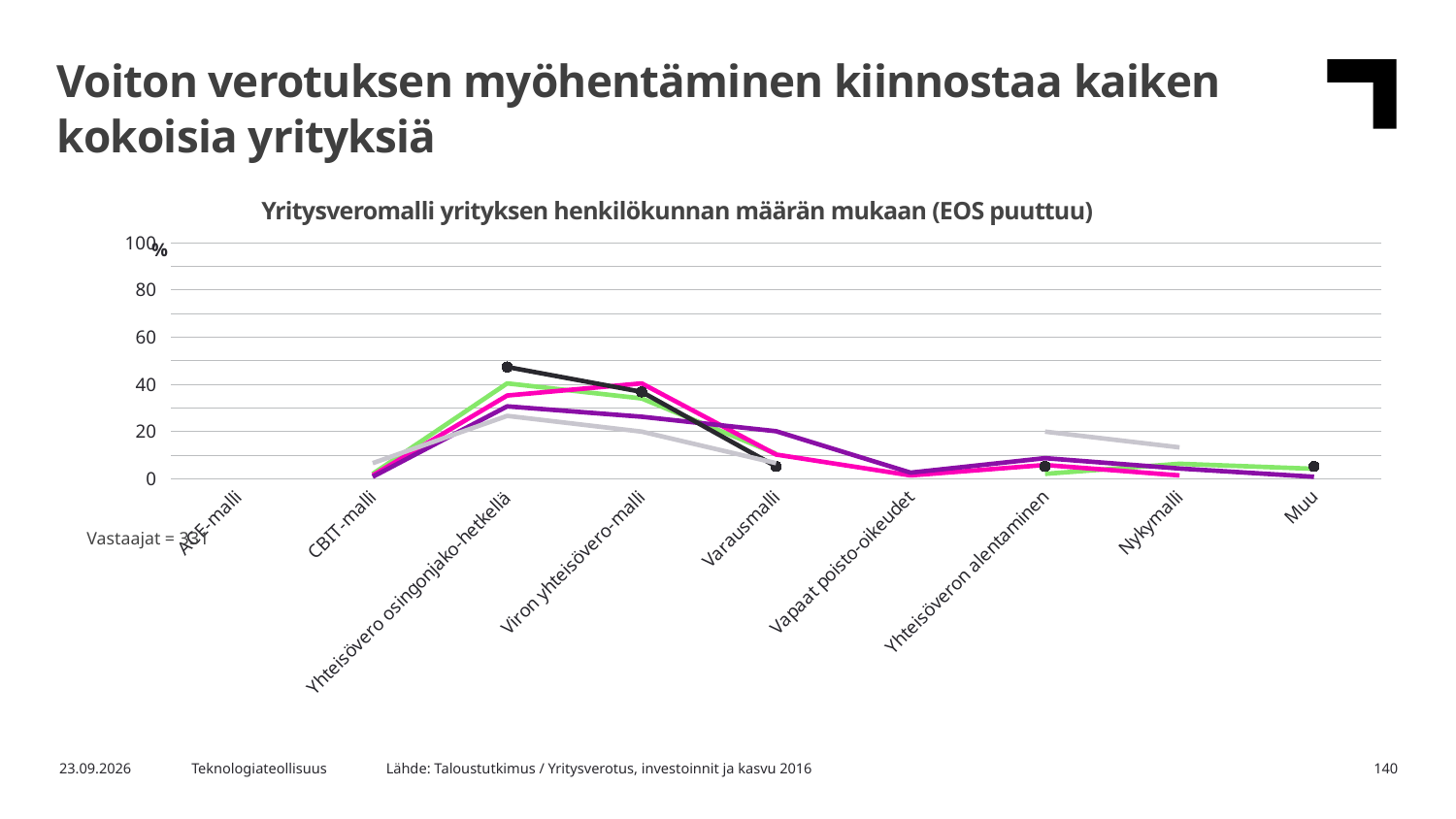
Does the black line rise or fall from Yhteisövero osingonjako-hetkellä to Varausmalli? fall What kind of chart is shown on the slide? line chart What is the title of the chart? Yritysveromalli yrityksen henkilökunnan määrän mukaan (EOS puuttuu) Is the value of the black line for Yhteisövero osingonjako-hetkellä greater or less than 40? greater For which category does the black line reach its highest value? Yhteisövero osingonjako-hetkellä How many categories are shown on the x axis of the chart? 9 Is the value of the black line for Varausmalli greater or less than 20? less Is the value of the gray line for Nykymalli greater or less than 20? less For the black line, which is larger: the value for Yhteisövero osingonjako-hetkellä or the value for Viron yhteisövero-malli? Yhteisövero osingonjako-hetkellä